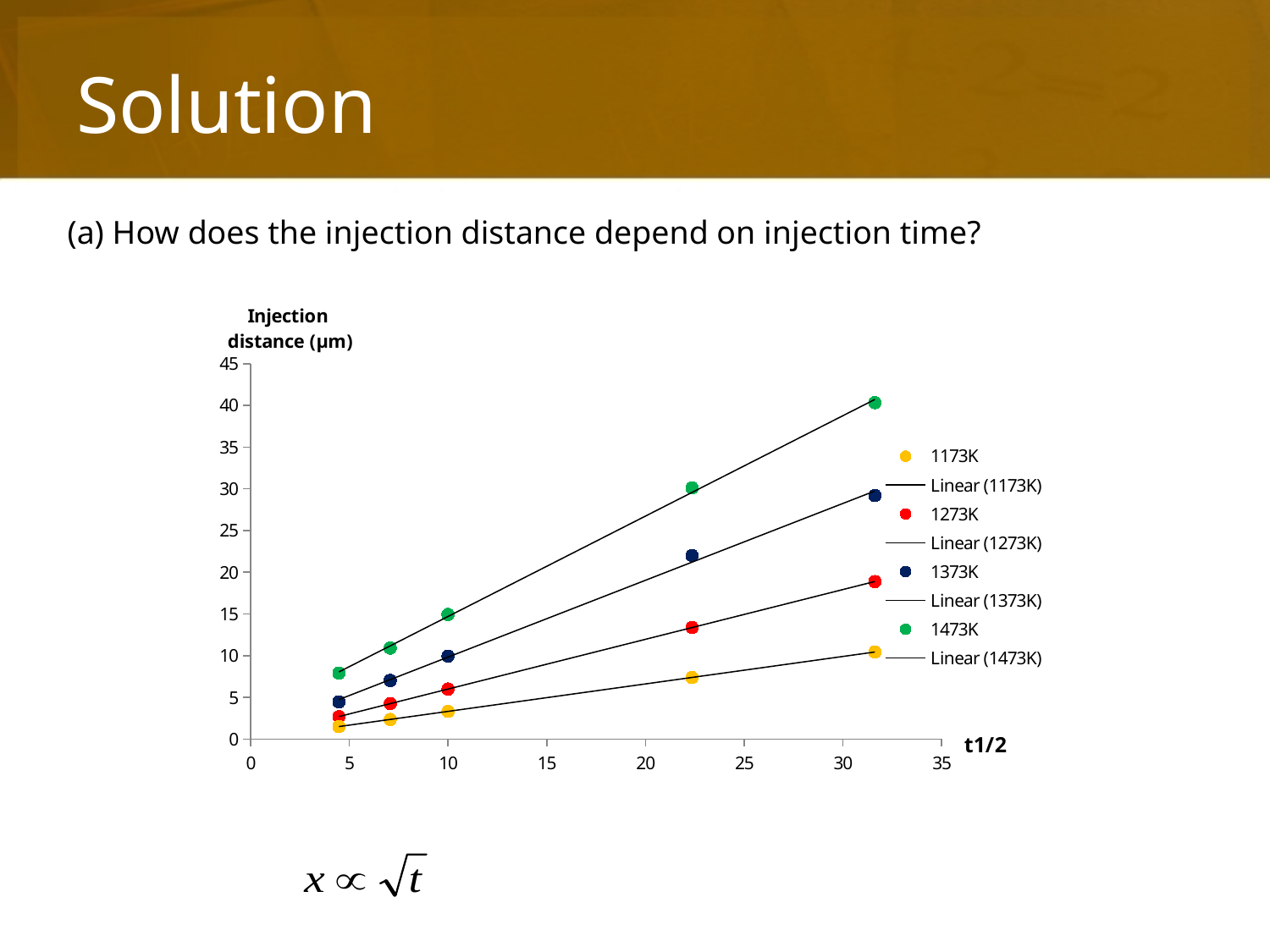
What is the label on the vertical axis of the chart? Injection distance (μm) At the rightmost data point, which series has the larger injection distance, 1473K or 1173K? 1473K What is the label on the horizontal axis of the chart? t1/2 How many data points are plotted for the 1473K series? 5 Do the injection distance values rise or fall as t1/2 increases? rise How many temperature series of data points are plotted on the chart? 4 Which temperature series has the highest injection distance values on the chart? 1473K How many entries does the chart legend list? 8 What kind of chart is shown on the slide? scatter chart Is the injection distance for the 1173K series at its fourth point (t1/2 of about 22) greater or less than 10? less Is the injection distance for the 1273K series at its rightmost point greater or less than 20? less Which temperature series has the lowest injection distance values on the chart? 1173K